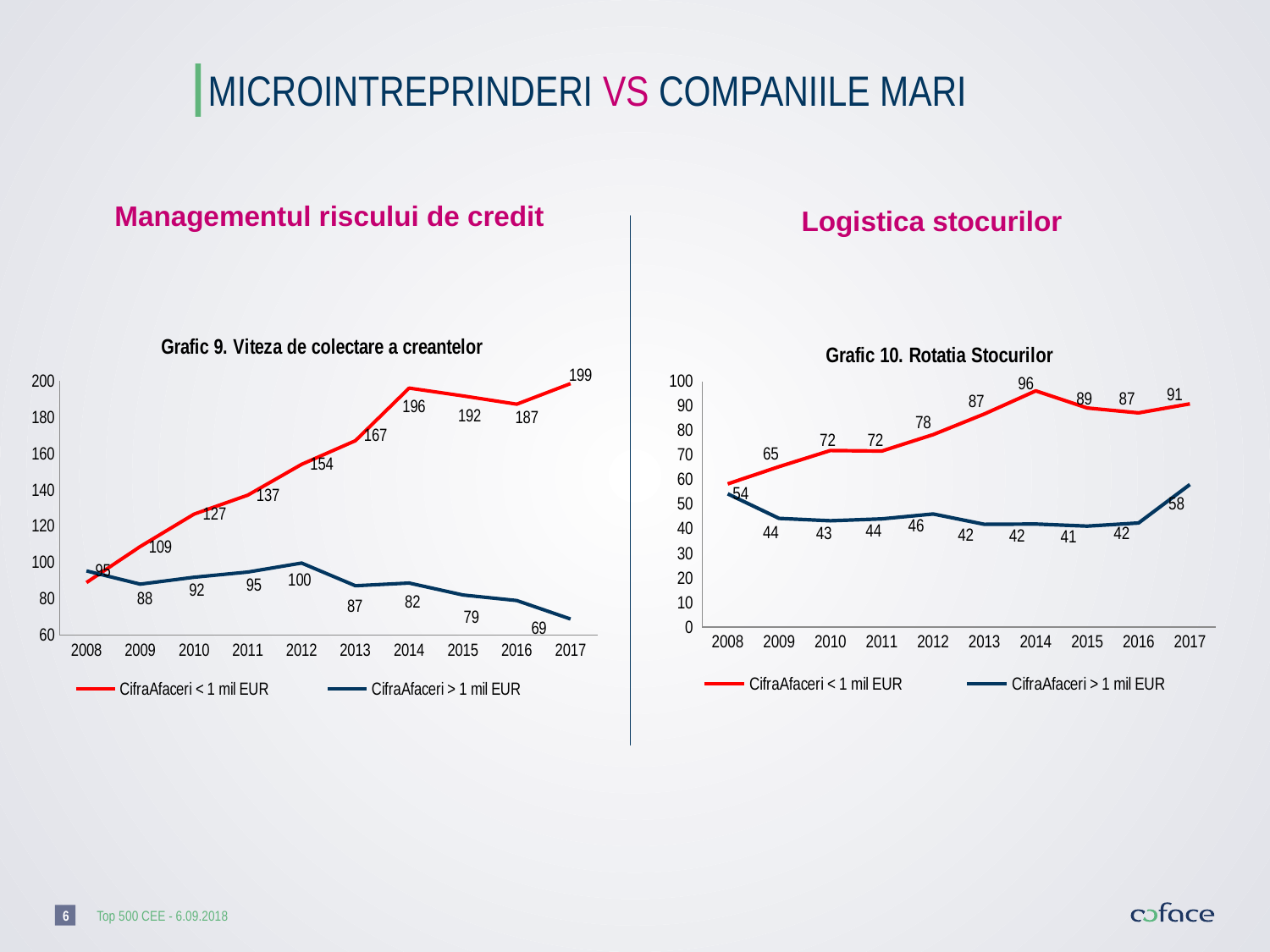
In Grafic 9 (Viteza de colectare a creantelor), what is the difference between the two series in 2016? 108 In Grafic 9 (Viteza de colectare a creantelor), is the value for CifraAfaceri > 1 mil EUR in 2017 greater or less than 80? less In Grafic 9 (Viteza de colectare a creantelor), what is the value for CifraAfaceri > 1 mil EUR in 2012? 100 In Grafic 10 (Rotatia Stocurilor), what is the value for CifraAfaceri < 1 mil EUR in 2014? 96 In Grafic 10 (Rotatia Stocurilor), what is the value for CifraAfaceri > 1 mil EUR in 2017? 58 In Grafic 10 (Rotatia Stocurilor), which series has the larger value in 2013? CifraAfaceri < 1 mil EUR How many years are shown on the x axis of Grafic 10 (Rotatia Stocurilor)? 10 What type of chart is Grafic 9 (Viteza de colectare a creantelor)? line chart In Grafic 9 (Viteza de colectare a creantelor), what is the value for CifraAfaceri < 1 mil EUR in 2017? 199 In Grafic 9 (Viteza de colectare a creantelor), does the CifraAfaceri > 1 mil EUR series generally rise or fall from 2012 to 2016? fall In Grafic 9 (Viteza de colectare a creantelor), in which year does the CifraAfaceri < 1 mil EUR series reach its highest value? 2017 In Grafic 10 (Rotatia Stocurilor), in which year is the CifraAfaceri > 1 mil EUR series lowest? 2015